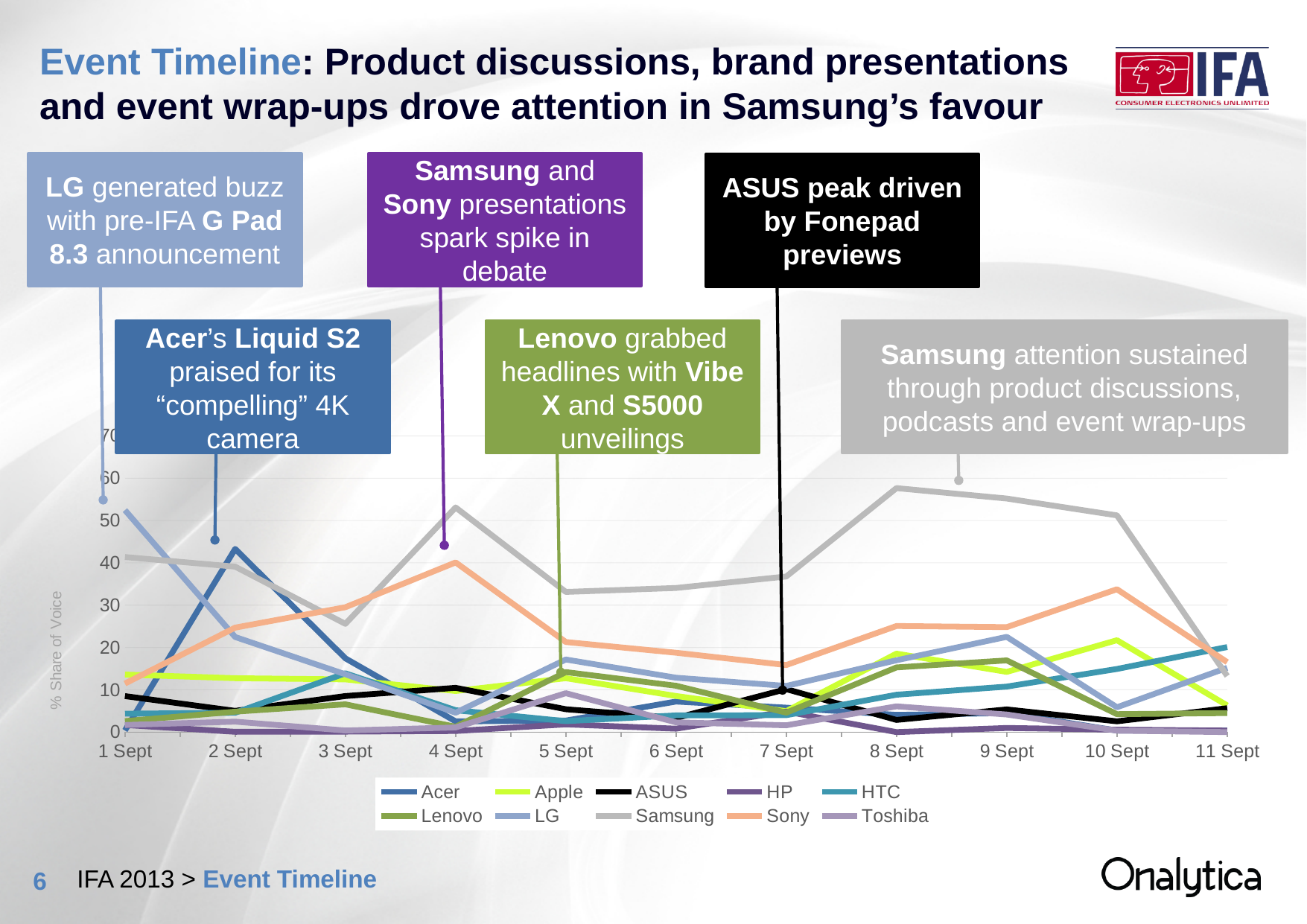
What is the label on the y axis? % Share of Voice How many dates are shown along the x axis? 11 Which series has the highest value on 8 Sept? Samsung On 2 Sept, which is larger, the value for Acer or the value for LG? Acer Is the value for Samsung on 8 Sept greater or less than 50? greater What kind of chart is shown on the slide? line chart Which series has the highest value on 2 Sept? Acer Is the value for Sony on 4 Sept greater or less than 30? greater How many series does the legend list? 10 Which series has the highest value on 1 Sept? LG Does the Samsung line rise or fall from 8 Sept to 11 Sept? fall Is the value for Samsung on 11 Sept greater or less than 30? less